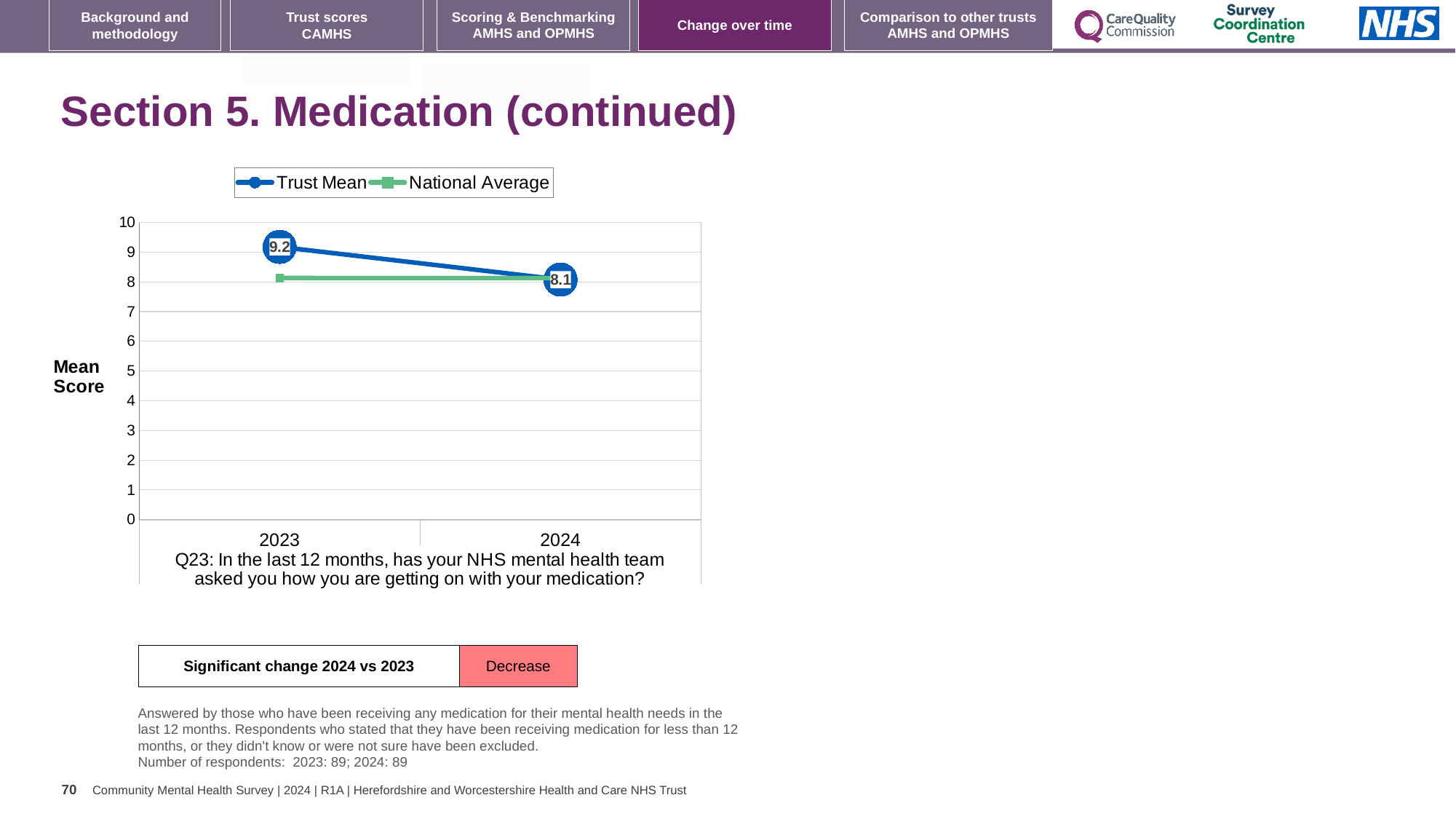
What kind of chart is shown on the slide? line chart In which year is the Trust Mean lowest? 2024 What is the Trust Mean value for 2024? 8.1 How many years are shown on the x axis of the chart? 2 Does the Trust Mean rise or fall from 2023 to 2024? fall What is the difference between the Trust Mean in 2023 and in 2024? 1.1 In 2023, which is larger: the Trust Mean or the National Average? Trust Mean What is the Trust Mean value for 2023? 9.2 Is the National Average value for 2023 greater or less than 7? greater How many series does the chart legend list? 2 What is the label on the y axis of the chart? Mean Score In which year is the Trust Mean highest? 2023